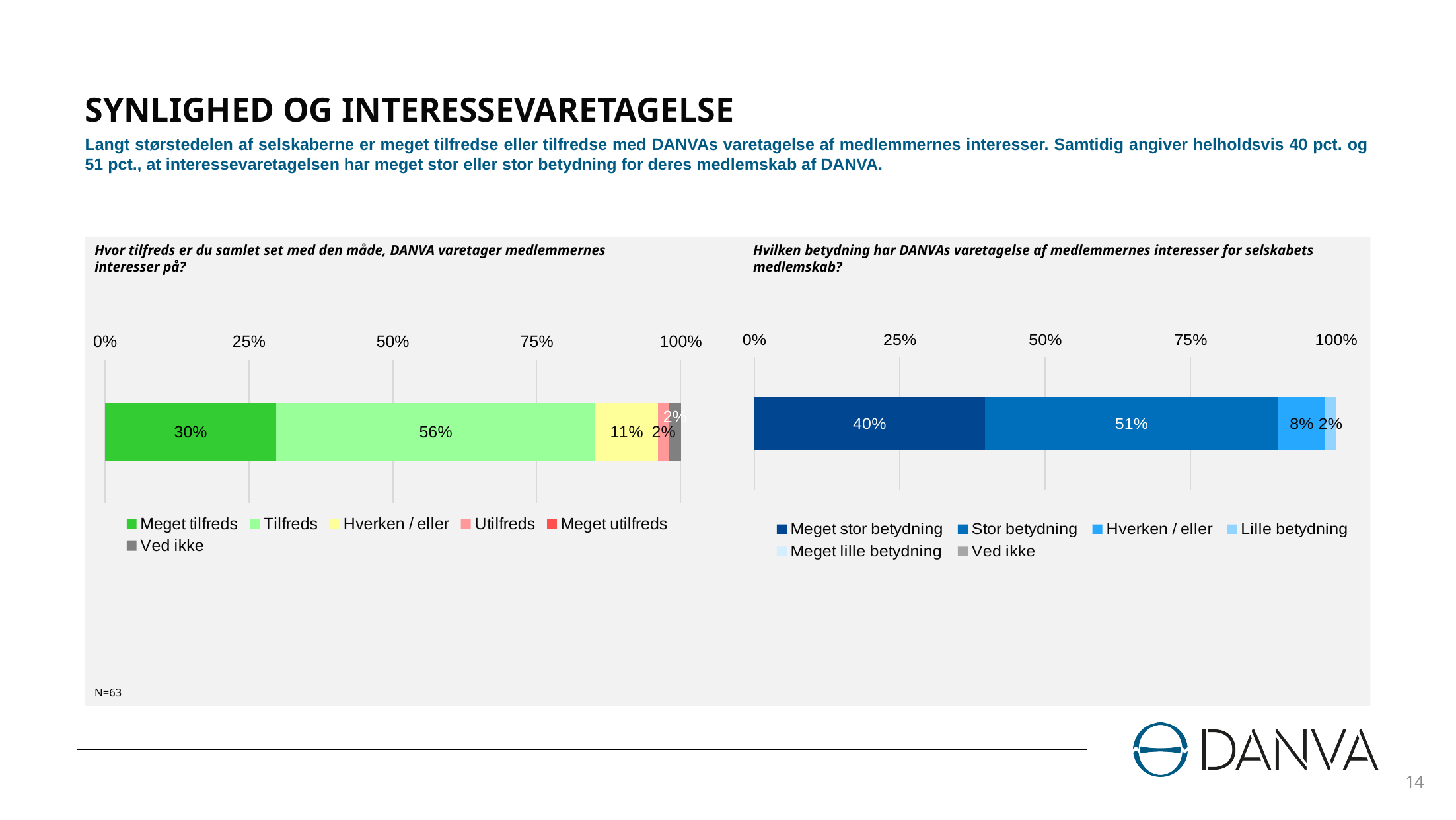
What type of chart is the left chart ("Hvor tilfreds er du samlet set...")? Stacked bar chart In the right chart ("Hvilken betydning har DANVAs varetagelse..."), what percentage is shown for Meget stor betydning? 40% In the right chart ("Hvilken betydning har DANVAs varetagelse..."), which is larger, Meget stor betydning or Stor betydning? Stor betydning In the left chart ("Hvor tilfreds er du samlet set..."), what is the difference between the Tilfreds and Meget tilfreds shares? 26% In the left chart ("Hvor tilfreds er du samlet set..."), what percentage is shown for Hverken / eller? 11% In the left chart ("Hvor tilfreds er du samlet set..."), which category has the largest share? Tilfreds In the left chart ("Hvor tilfreds er du samlet set..."), what percentage is shown for Tilfreds? 56% In the right chart ("Hvilken betydning har DANVAs varetagelse..."), what percentage is shown for Hverken / eller? 8% In the right chart ("Hvilken betydning har DANVAs varetagelse..."), what is the combined share of Meget stor betydning and Stor betydning? 91% How many entries does the legend of the right chart ("Hvilken betydning har DANVAs varetagelse...") list? 6 In the left chart ("Hvor tilfreds er du samlet set..."), what percentage is shown for Meget tilfreds? 30% In the right chart ("Hvilken betydning har DANVAs varetagelse..."), what percentage is shown for Stor betydning? 51%